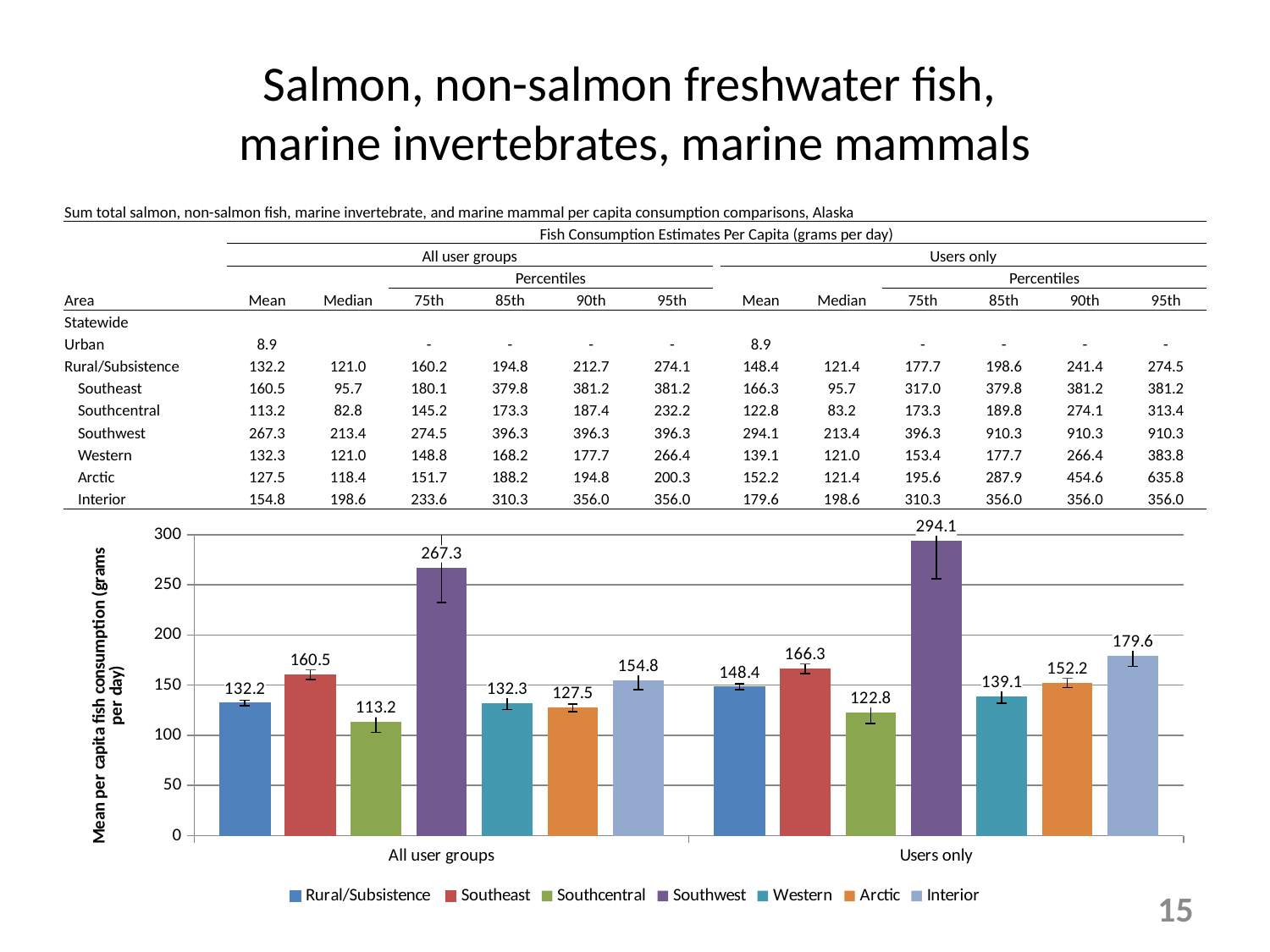
What is the label of the y axis? Mean per capita fish consumption (grams per day) What is the mean per capita fish consumption for Southwest in the All user groups category? 267.3 Which is larger: the Southeast value for All user groups or the Southeast value for Users only? Users only What is the difference between the Southwest values for Users only and All user groups? 26.8 How many categories are shown on the x axis? 2 How many series does the legend list? 7 Which series has the highest value in the Users only category? Southwest What kind of chart is shown on the slide? bar chart Which series has the lowest value in the All user groups category? Southcentral What is the value for Rural/Subsistence in the Users only category? 148.4 What is the mean per capita fish consumption for Interior in the Users only category? 179.6 Is the value for Southwest in the Users only category greater or less than 250? greater